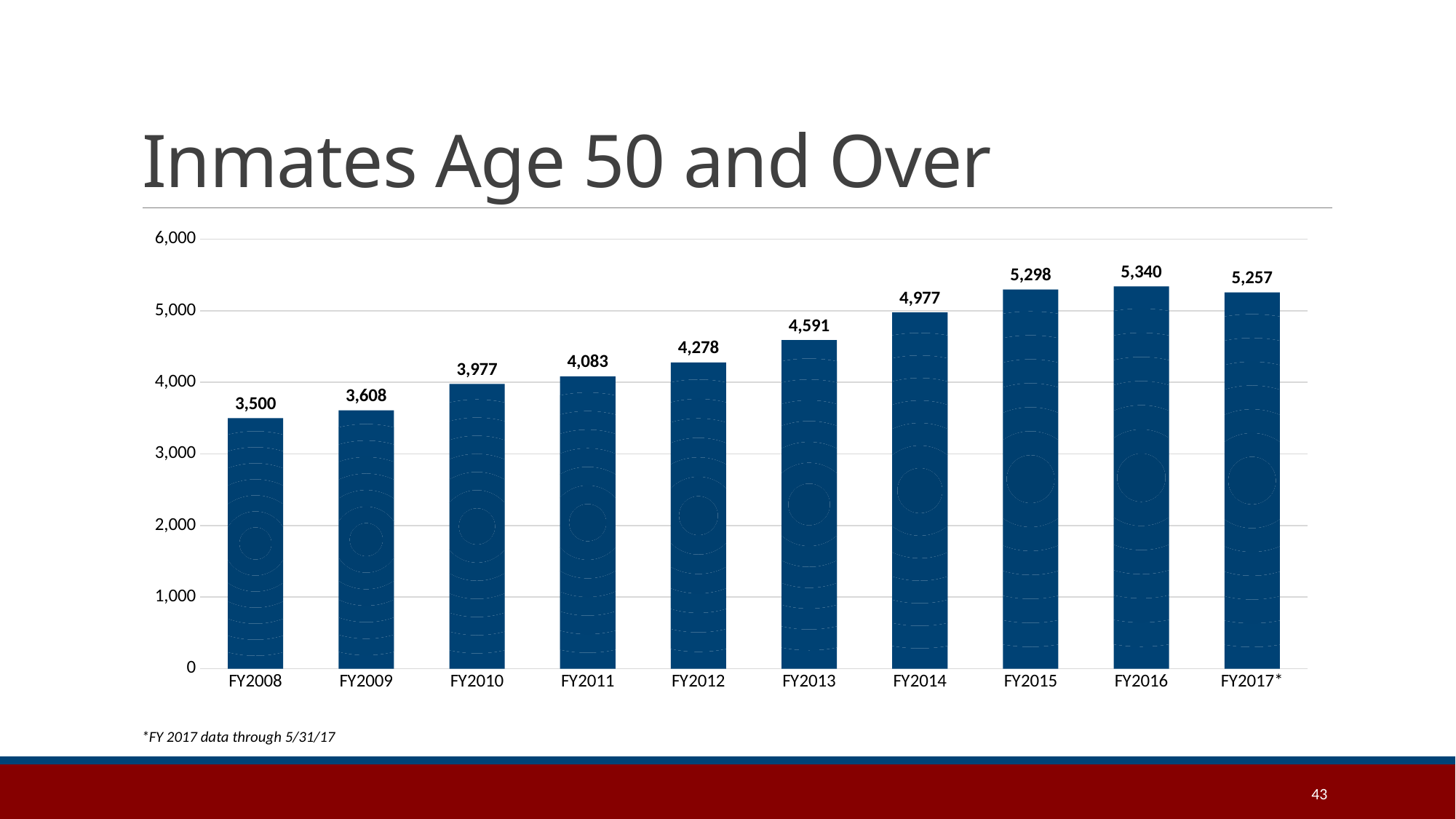
Which is larger, the value for FY2015 or the value for FY2017*? FY2015 What is the value for FY2013? 4,591 What is the value for FY2008? 3,500 What is the difference between the values for FY2014 and FY2013? 386 What is the difference between the values for FY2016 and FY2008? 1,840 Which fiscal year has the lowest value? FY2008 What is the value for FY2017*? 5,257 What kind of chart is shown on the slide? bar chart Is the value for FY2012 greater or less than 4,000? greater What is the title of the chart? Inmates Age 50 and Over Which fiscal year has the highest value? FY2016 How many fiscal years are shown on the x axis? 10